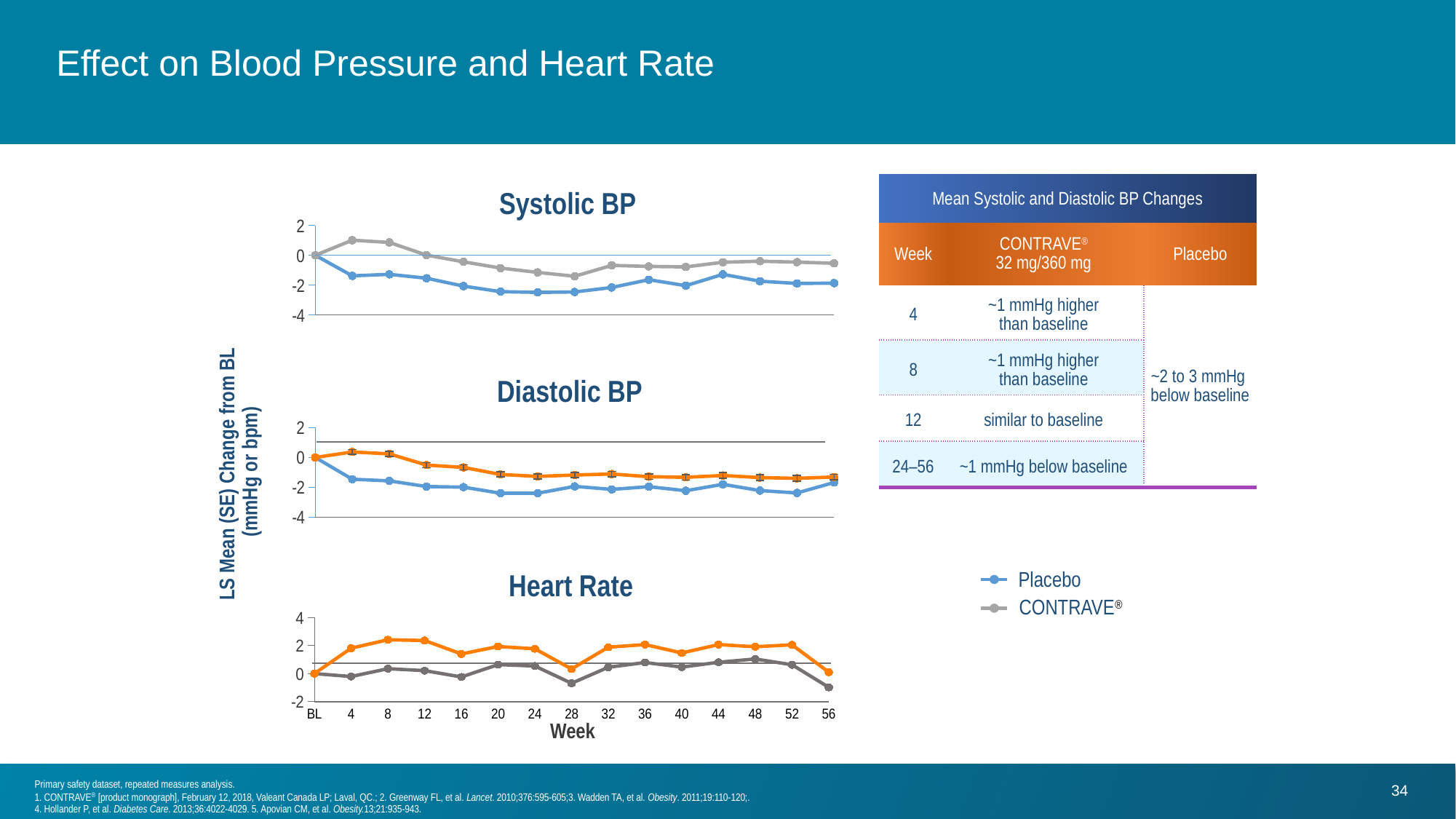
In the Diastolic BP chart, is the Placebo value at week 52 greater or less than -2? less What is the label of the shared y axis for the three charts? LS Mean (SE) Change from BL (mmHg or bpm) In the Heart Rate chart, does the orange series rise or fall from week 52 to week 56? fall In the Systolic BP chart, which series has the higher value at week 4, Placebo or CONTRAVE? CONTRAVE In the Systolic BP chart, is the Placebo value at week 24 greater or less than -2? less In the Heart Rate chart, is the orange series value at week 8 greater or less than 2? greater What kind of chart is the Systolic BP chart? line chart How many series does the legend list for the charts? 2 In the Systolic BP chart, does the Placebo series rise or fall from BL to week 4? fall How many time points (including BL) are plotted along the x axis of the Heart Rate chart? 15